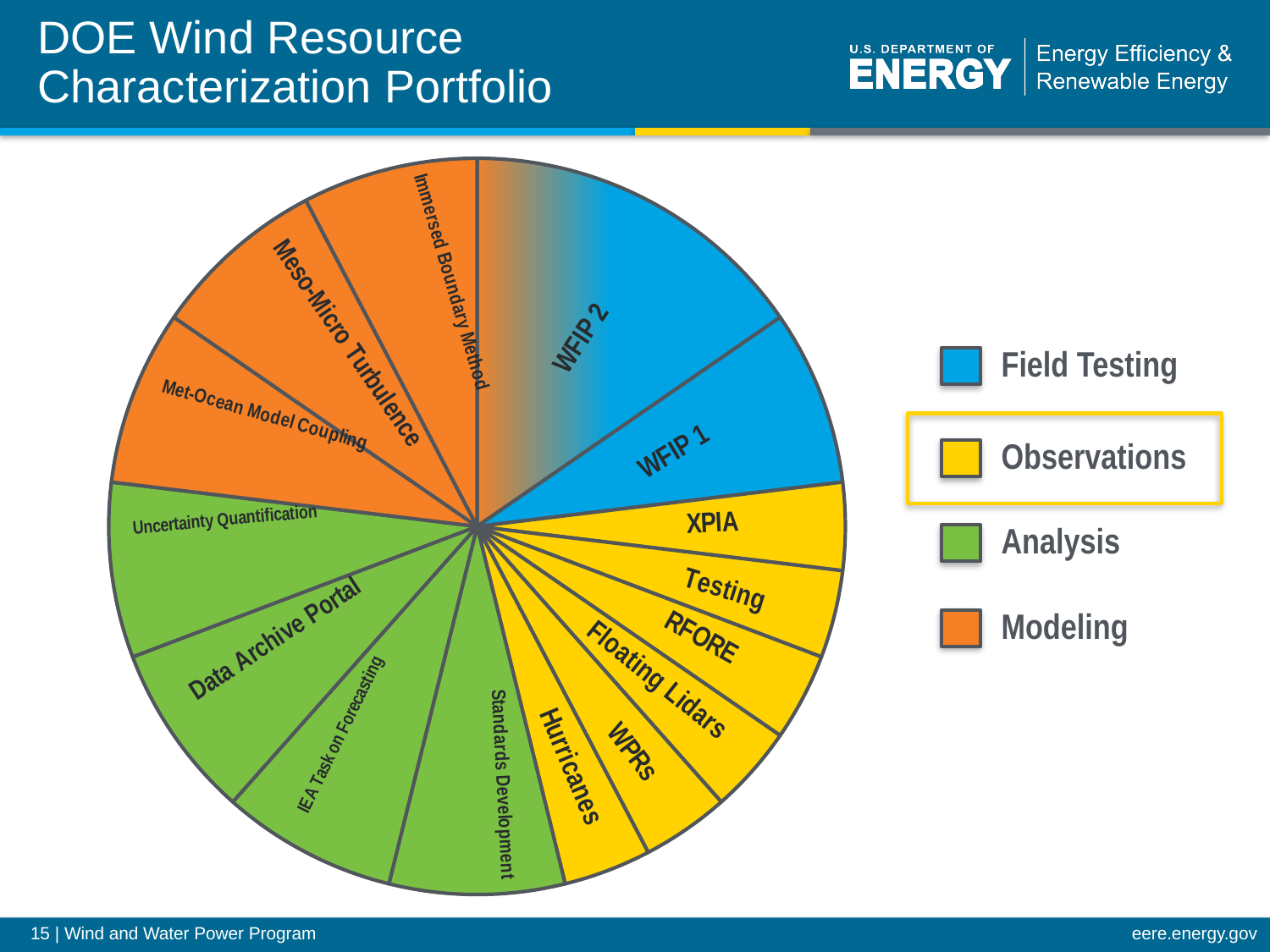
How many slices belong to the Modeling category? 3 Which legend category is shown in blue? Field Testing How many slices does the pie chart have? 15 Which legend category is highlighted with a yellow outline box? Observations Which slice of the pie chart is the largest? WFIP 2 What kind of chart is shown on the slide? Pie chart How many categories does the legend list? 4 Which slice is larger, Uncertainty Quantification or XPIA? Uncertainty Quantification Which slice is larger, Data Archive Portal or Hurricanes? Data Archive Portal Which slice is larger, WFIP 2 or WFIP 1? WFIP 2 How many slices belong to the Analysis category? 4